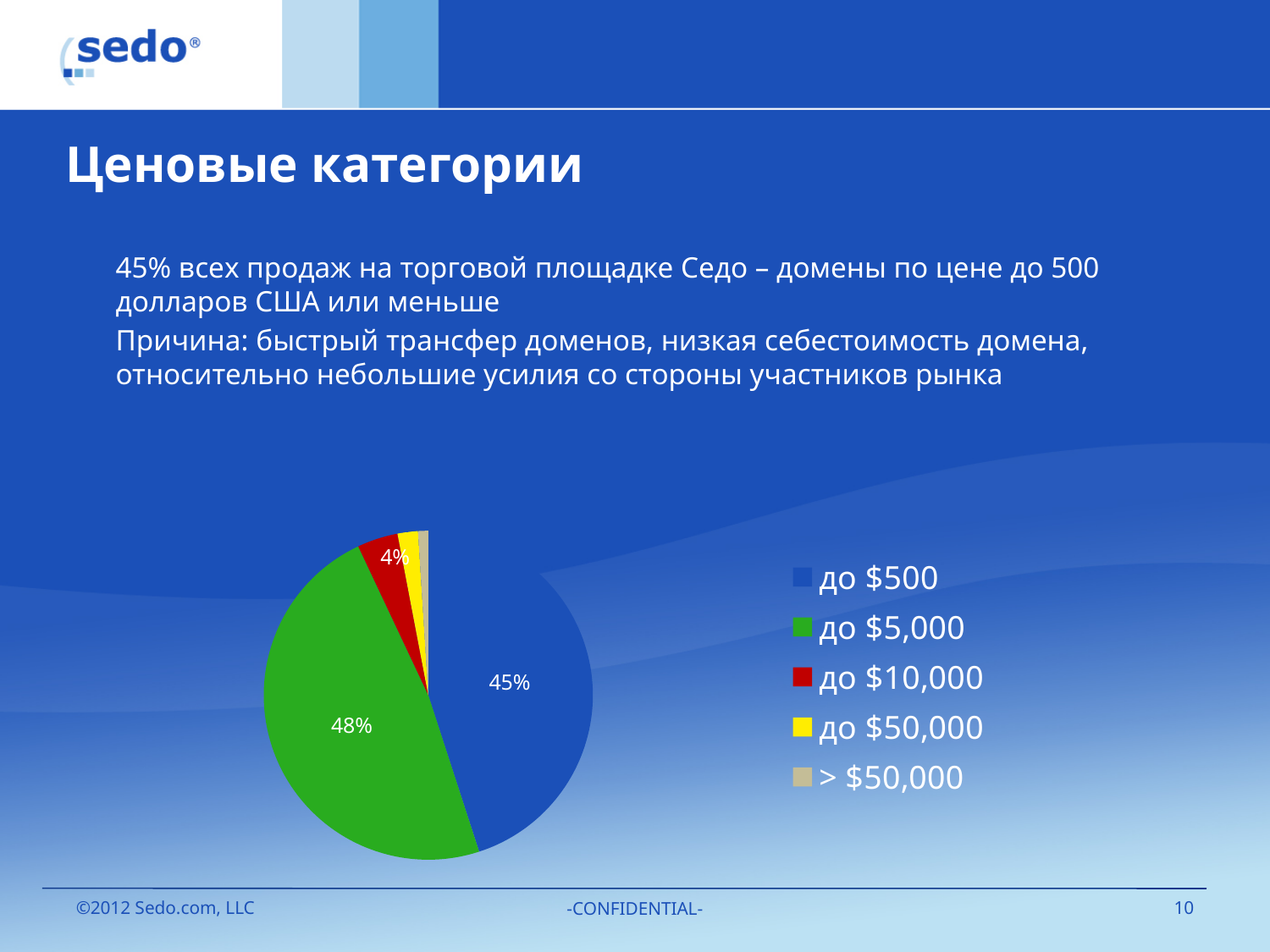
What colour represents the "до $10,000" category in the legend? Red What is the difference in percentage points between the "до $5,000" slice and the "до $500" slice? 3 What is the value shown for the "до $10,000" category? 4% What is the value shown for the "до $5,000" category? 48% How many categories does the pie chart show? 5 What share of the pie does the "до $500" slice represent? 45% Which is larger, the slice for "до $5,000" or the slice for "до $500"? до $5,000 What is the title of the slide containing the chart? Ценовые категории Which category has the smallest slice of the pie? > $50,000 What is the difference in percentage points between the "до $500" slice and the "до $10,000" slice? 41 What kind of chart is shown on the slide? Pie chart Which category has the largest slice of the pie? до $5,000